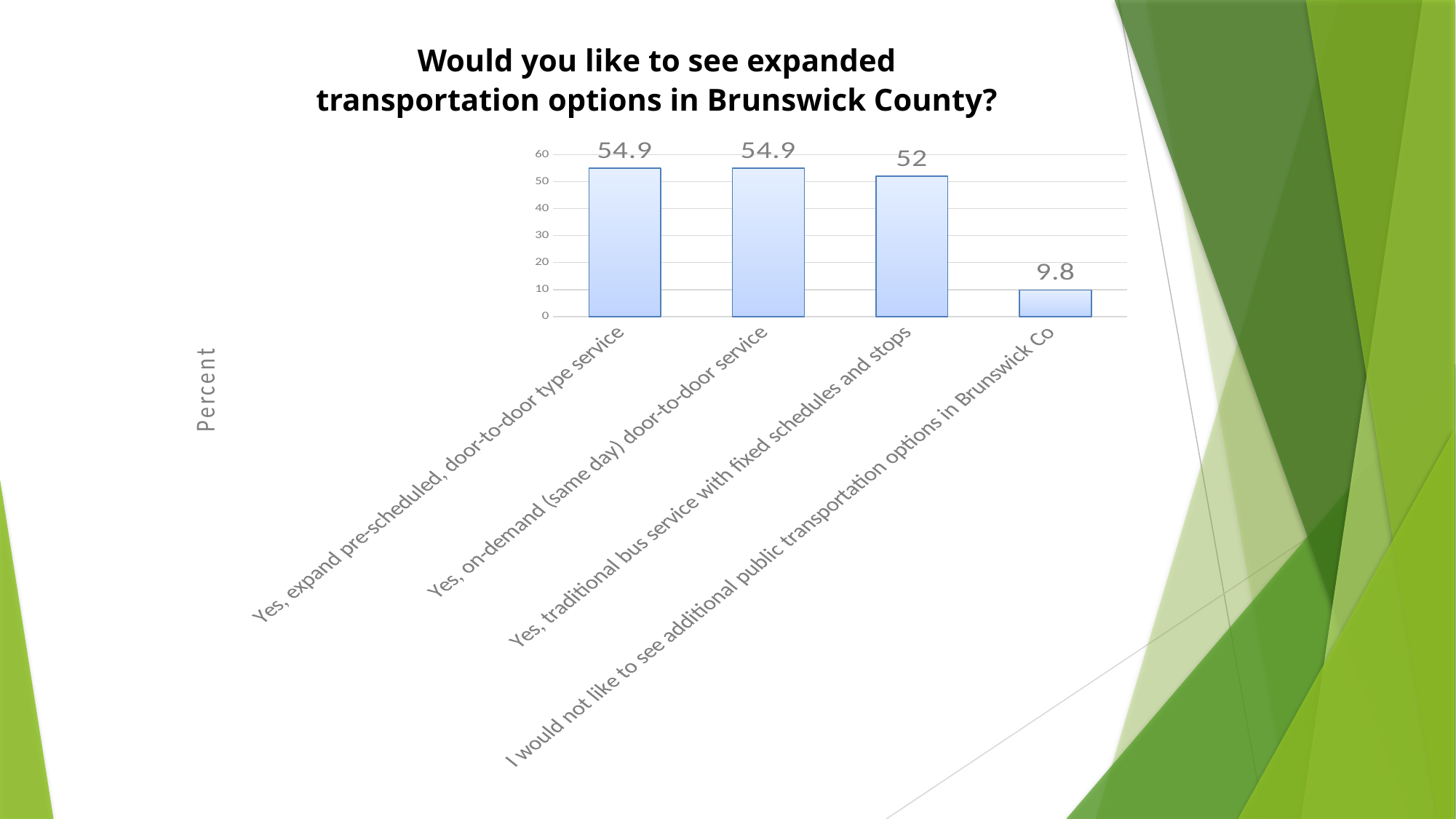
How many categories are shown in the chart? 4 What is the difference between the value for "Yes, traditional bus service with fixed schedules and stops" and the value for "I would not like to see additional public transportation options in Brunswick Co"? 42.2 Is the value for "I would not like to see additional public transportation options in Brunswick Co" greater or less than 20? less What is the label on the vertical axis of the chart? Percent Which category has the lowest value? I would not like to see additional public transportation options in Brunswick Co What is the value for "Yes, on-demand (same day) door-to-door service"? 54.9 What is the value for "Yes, traditional bus service with fixed schedules and stops"? 52 What is the value for "Yes, expand pre-scheduled, door-to-door type service"? 54.9 What is the difference between the value for "Yes, expand pre-scheduled, door-to-door type service" and the value for "Yes, traditional bus service with fixed schedules and stops"? 2.9 What kind of chart is shown on the slide? bar chart What is the value for "I would not like to see additional public transportation options in Brunswick Co"? 9.8 Which is larger: the value for "Yes, traditional bus service with fixed schedules and stops" or the value for "I would not like to see additional public transportation options in Brunswick Co"? Yes, traditional bus service with fixed schedules and stops